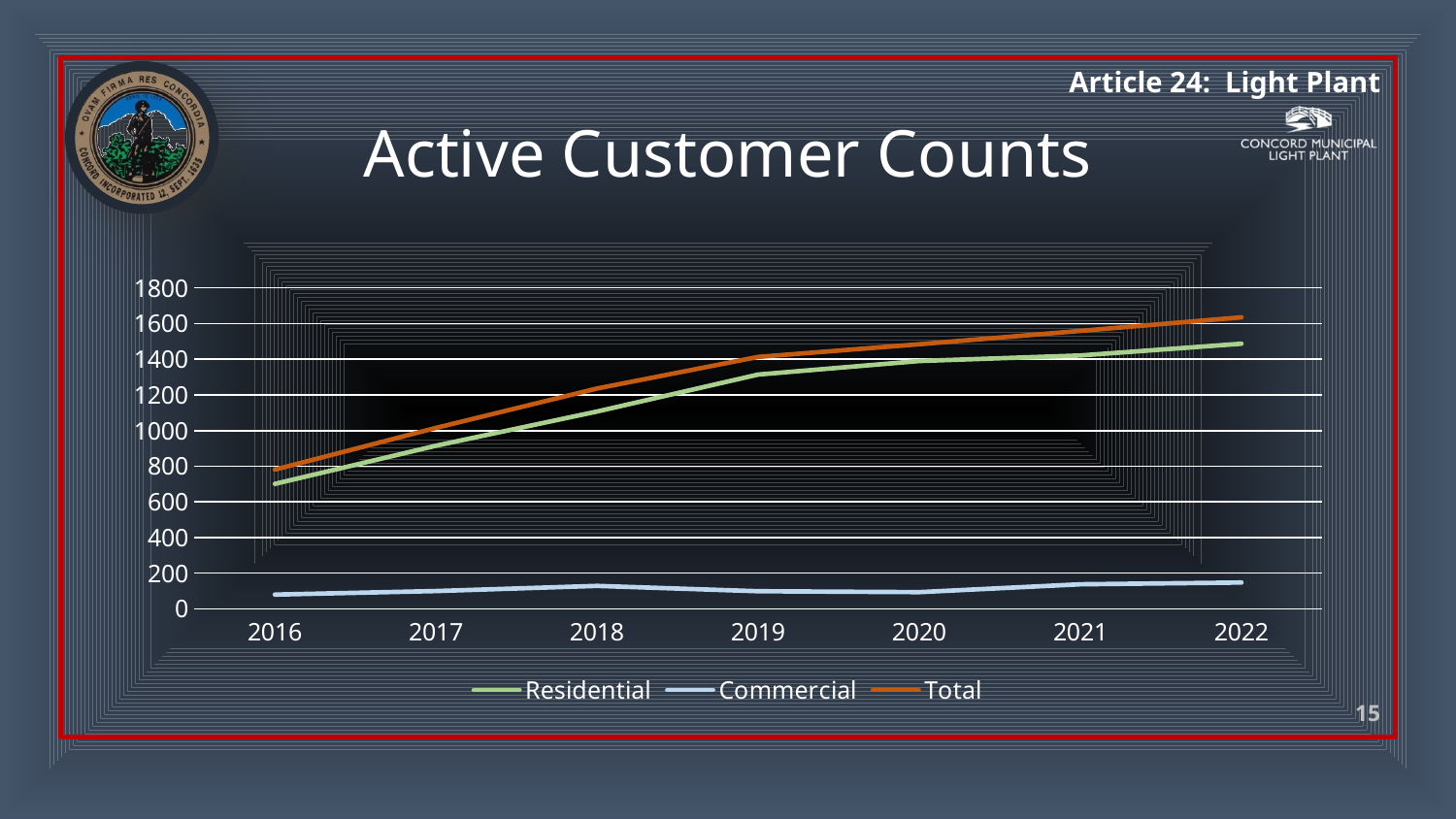
Does the Residential line rise or fall from 2016 to 2022? rise In 2020, which is larger, Residential or Commercial? Residential How many years are shown on the x axis? 7 What kind of chart is shown on the slide? line chart Which series has the highest values across the chart? Total What is the title of the chart? Active Customer Counts Is the value for Commercial in 2022 greater or less than 200? less Is the value for Residential in 2016 greater or less than 800? less Is the value for Residential in 2019 greater or less than 1400? less Which series has the lowest values across the chart? Commercial How many series does the legend list? 3